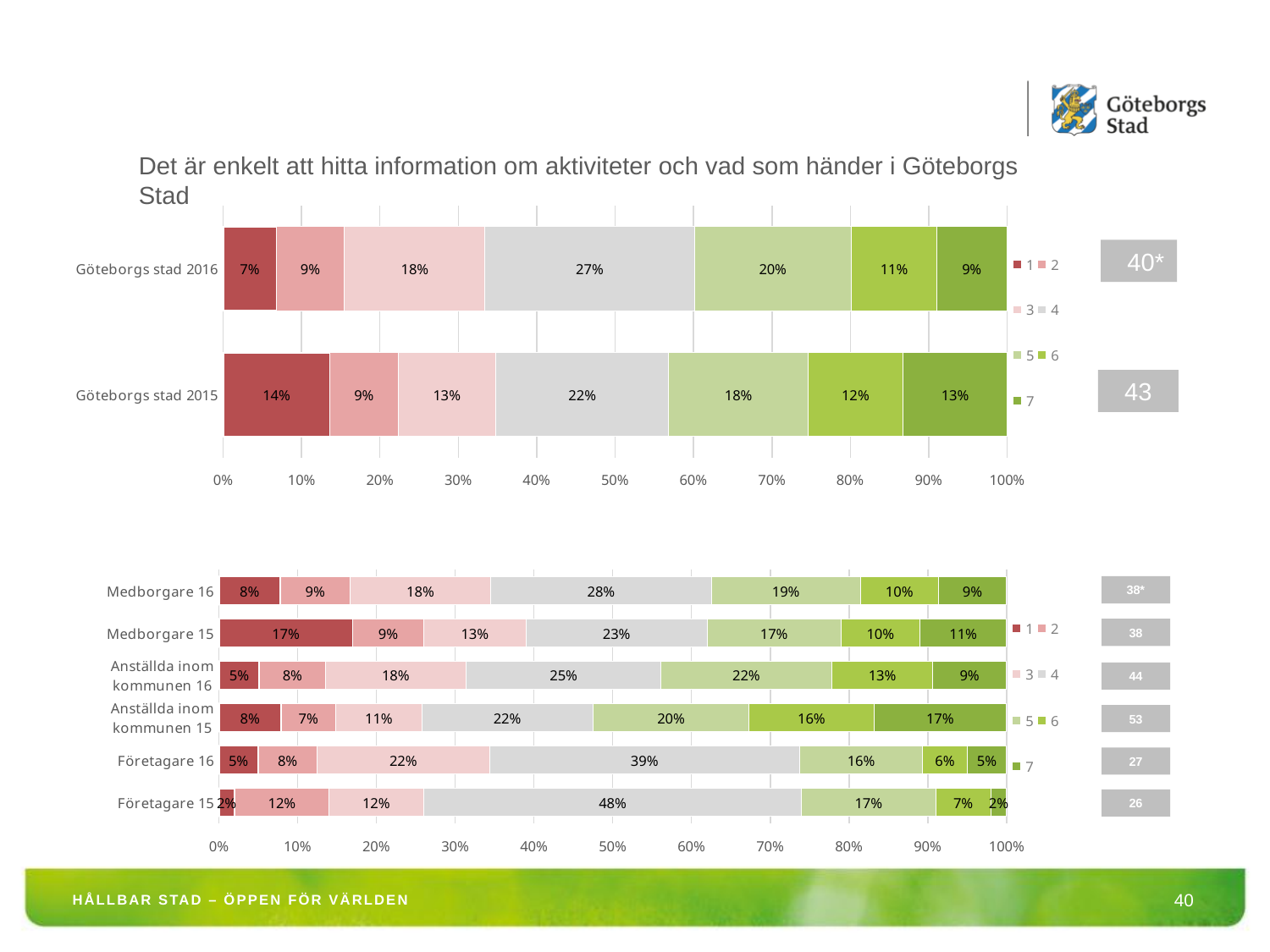
In the bottom chart, what is the value of series 4 for Företagare 15? 48% In the top chart, what is the value of series 1 for Göteborgs stad 2015? 14% How many categories (bars) does the bottom chart show? 6 In the top chart, what is the value of series 4 for Göteborgs stad 2016? 27% In the bottom chart, which category has the highest value for series 4? Företagare 15 In the bottom chart, what is the difference between the series 4 values for Företagare 15 and Företagare 16? 9 percentage points In the bottom chart, which has the larger series 7 value: Anställda inom kommunen 15 or Anställda inom kommunen 16? Anställda inom kommunen 15 What kind of chart is the top chart? Stacked bar chart In the top chart, what is the difference between the series 1 values for Göteborgs stad 2015 and Göteborgs stad 2016? 7 percentage points In the bottom chart, which category has the lowest value for series 1? Företagare 15 How many series does the legend of the top chart list? 7 How many categories (bars) does the top chart show? 2